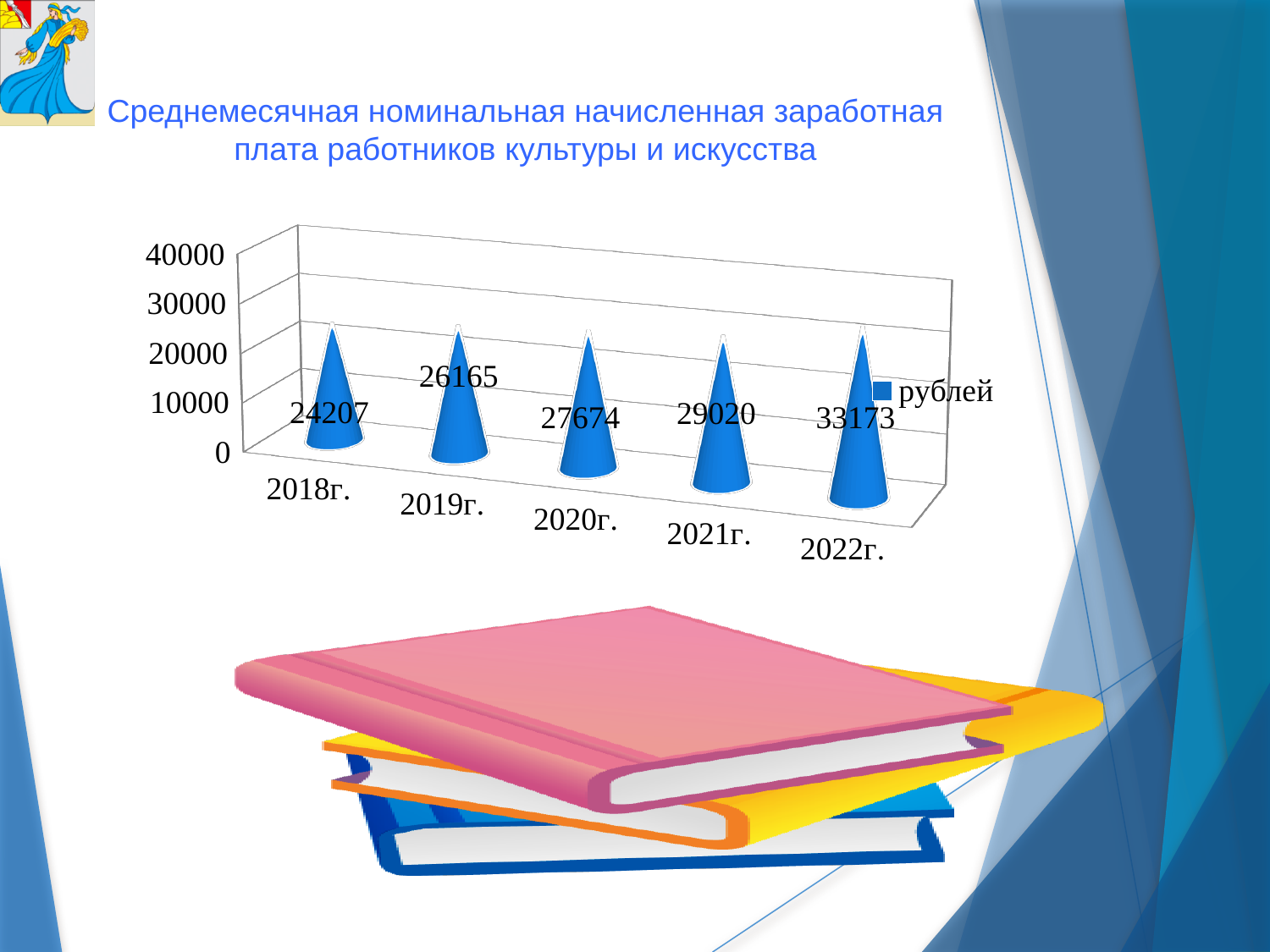
What is the legend entry of the chart? рублей Is the value for 2022г. greater or less than 30000? greater Which is larger, the value for 2020г. or the value for 2019г.? 2020г. Which year has the highest value? 2022г. Do the values rise or fall from 2018г. to 2022г.? rise What is the value for 2021г.? 29020 What is the value for 2018г.? 24207 What is the value for 2019г.? 26165 How many years are shown on the x axis? 5 Which year has the lowest value? 2018г. What is the difference between the values for 2022г. and 2021г.? 4153 What is the difference between the values for 2020г. and 2018г.? 3467